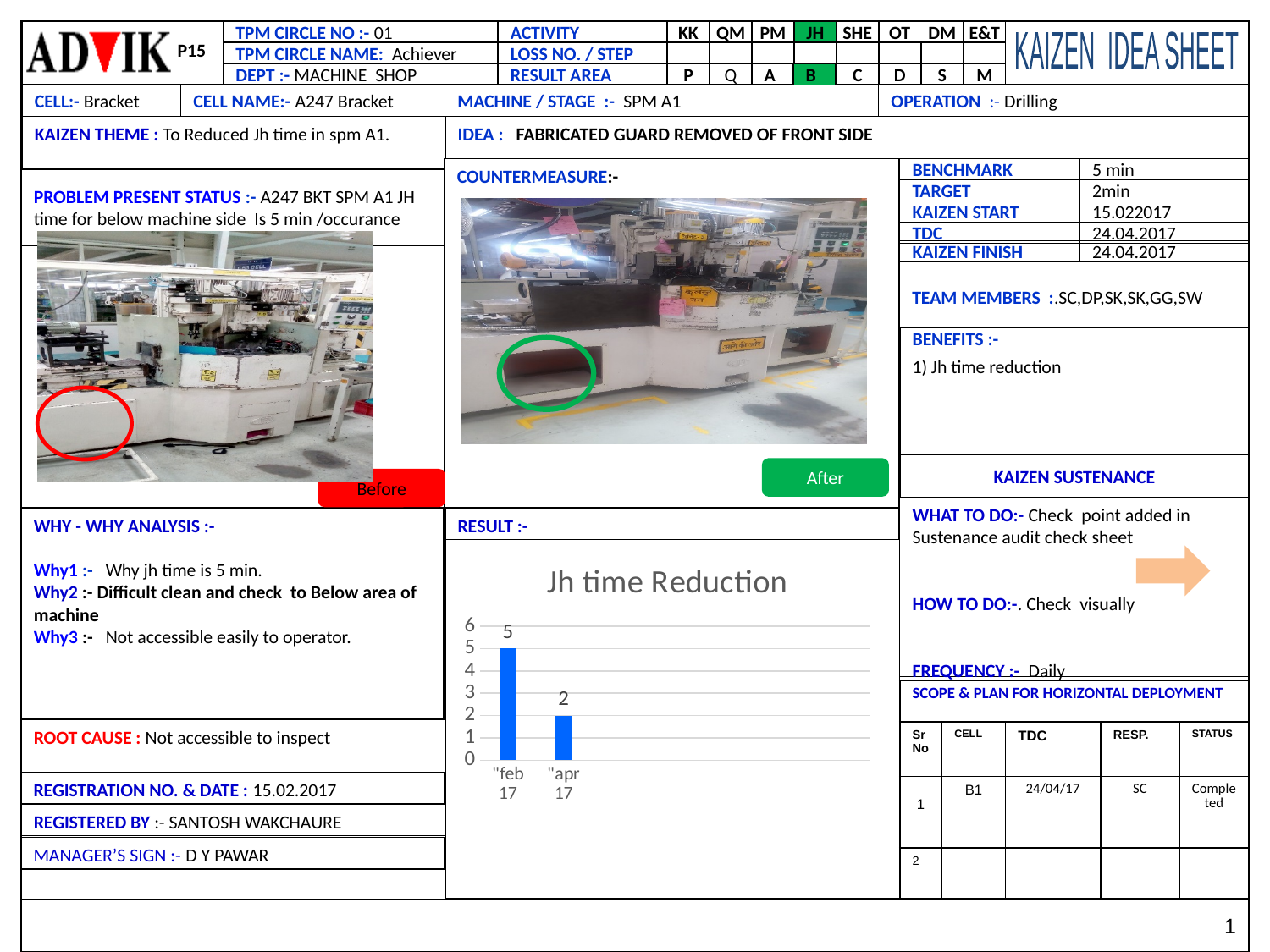
What is the title of the chart on the slide? Jh time Reduction What is the maximum value shown on the y axis of the Jh time Reduction chart? 6 Which category has the highest value in the Jh time Reduction chart? feb 17 Which category has the lowest value in the Jh time Reduction chart? apr 17 How many categories are plotted in the Jh time Reduction chart? 2 What is the value for "feb 17" in the Jh time Reduction chart? 5 What is the difference between the values for "feb 17" and "apr 17" in the Jh time Reduction chart? 3 Is the value for "feb 17" in the Jh time Reduction chart greater or less than 4? greater Do the values in the Jh time Reduction chart rise or fall from "feb 17" to "apr 17"? fall What type of chart is shown under RESULT? bar chart What is the value for "apr 17" in the Jh time Reduction chart? 2 In the Jh time Reduction chart, which is larger: the value for "feb 17" or "apr 17"? feb 17